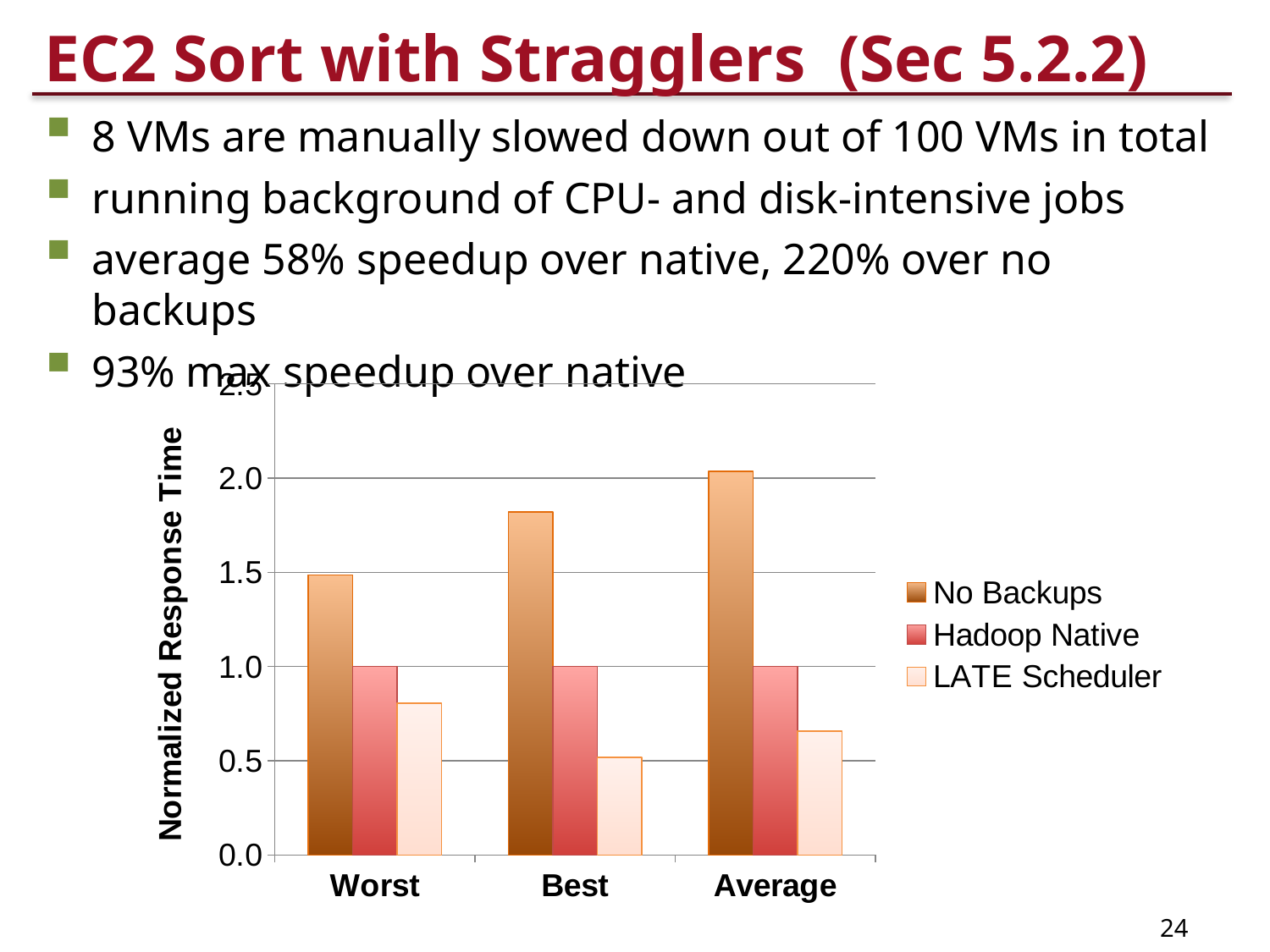
In which category is the No Backups bar the highest? Average Is the LATE Scheduler value for Worst greater or less than 0.5? greater What is the Normalized Response Time for Hadoop Native in the Average category? 1.0 How many categories are shown on the x axis of the chart? 3 What is the Normalized Response Time for Hadoop Native in the Worst category? 1.0 Is the LATE Scheduler value for Best greater or less than 1.0? less In which category is the LATE Scheduler bar the lowest? Best Is the No Backups value for Best greater or less than 1.5? greater In the Worst category, which is larger: No Backups or LATE Scheduler? No Backups How many series does the chart's legend list? 3 What is the title of the chart's y axis? Normalized Response Time What kind of chart is shown on the slide? bar chart